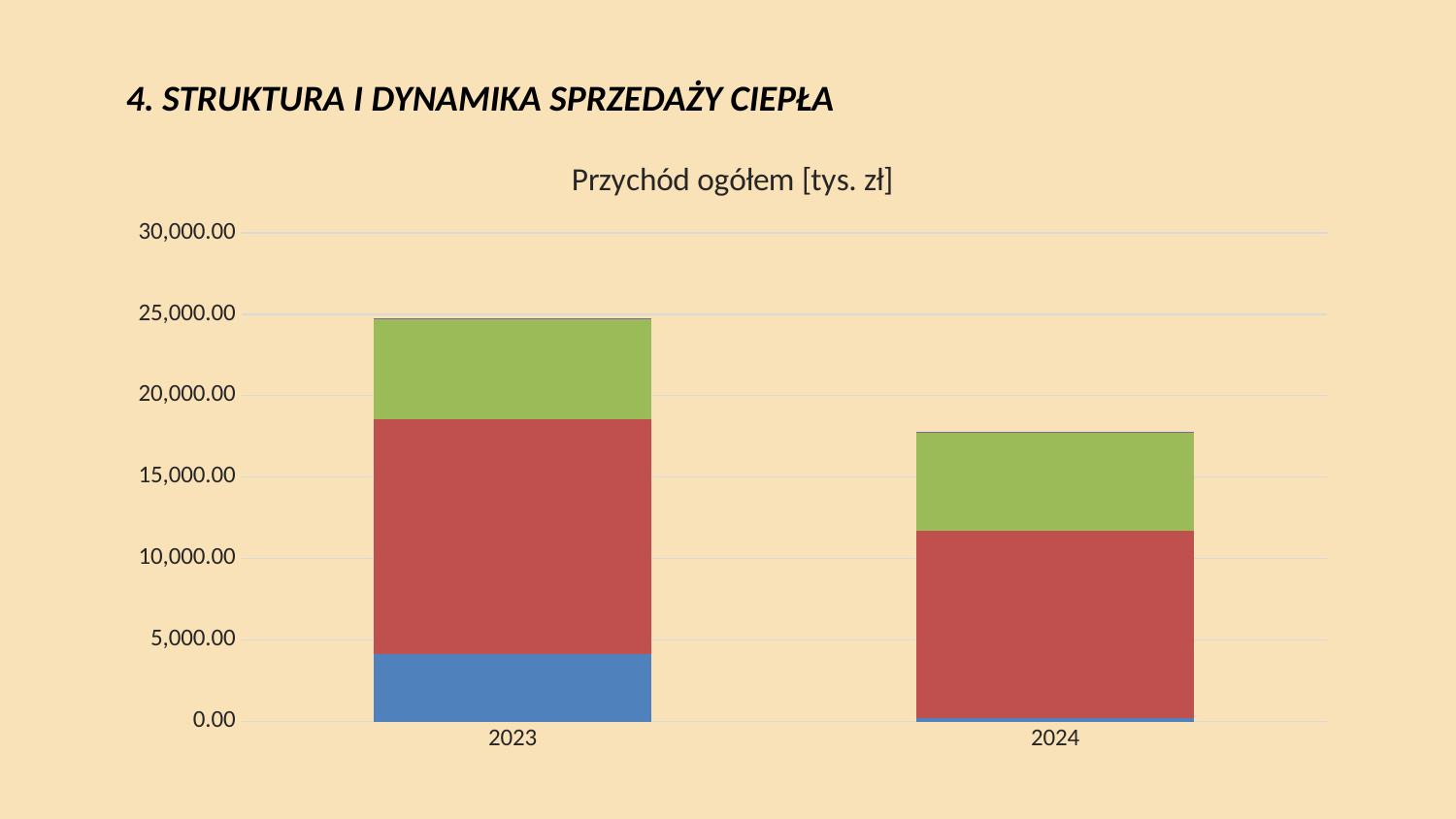
What type of chart is shown on the slide? Stacked bar chart Which is larger, the total bar for 2023 or the total bar for 2024? 2023 How many years (categories) are shown on the x axis? 2 What is the title of the chart? Przychód ogółem [tys. zł] Which year has the shorter stacked bar? 2024 Is the total bar for 2023 greater or less than 20,000.00? greater Which year has the taller stacked bar? 2023 Is the total bar for 2024 greater or less than 20,000.00? less Does the total revenue rise or fall from 2023 to 2024? fall Is the blue segment for 2023 greater or less than 5,000.00? less